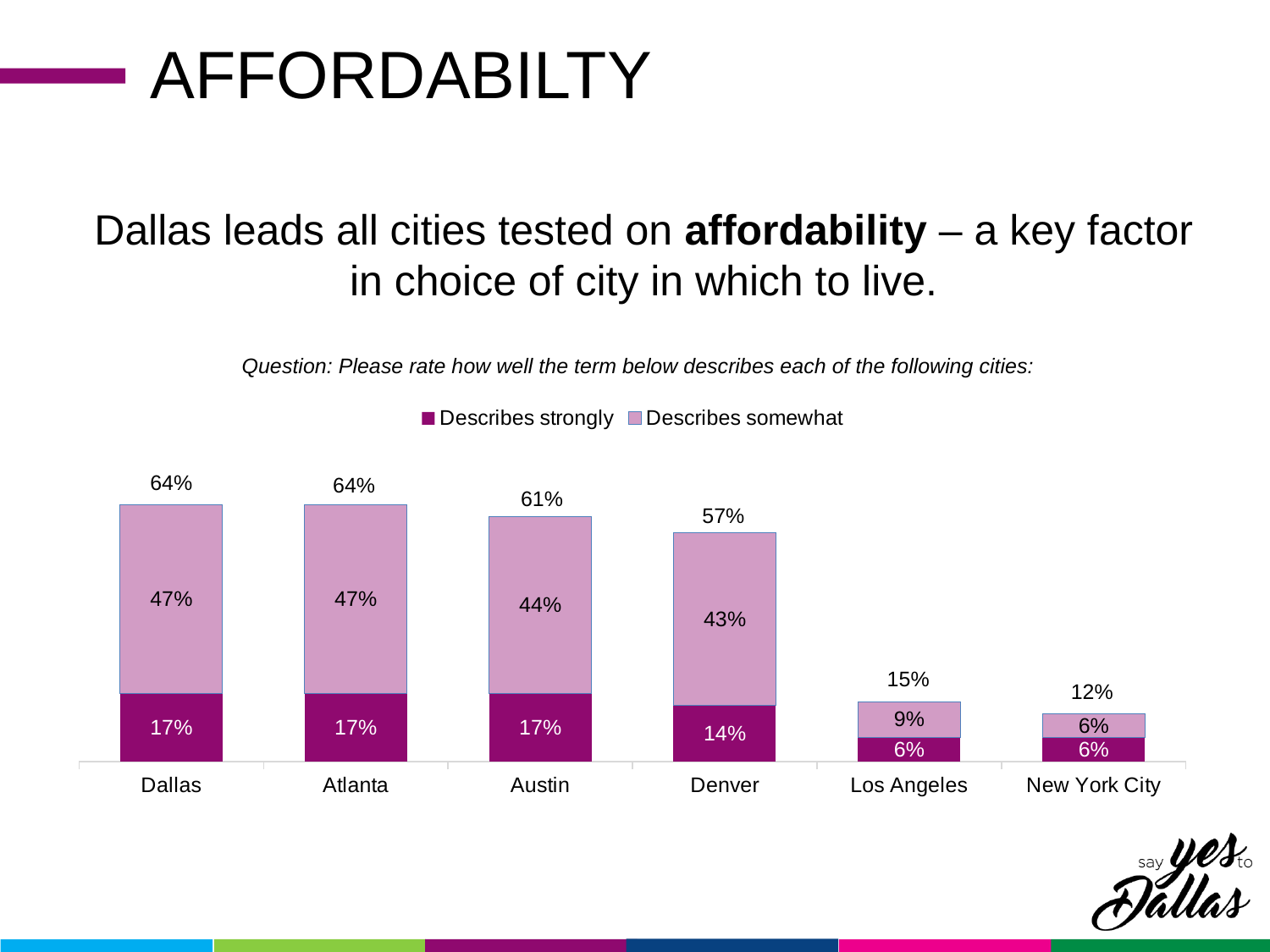
What kind of chart is shown on the slide? Stacked bar chart What is the "Describes somewhat" value for Denver? 43% How many cities are shown on the x axis? 6 What is the total stacked value shown above the bar for Austin? 61% What percentage of respondents said affordability "Describes strongly" for Dallas? 17% How many series does the legend list? 2 Which city has the lowest total stacked value? New York City What is the "Describes somewhat" value for Los Angeles? 9% Do the total values rise or fall moving from Dallas to New York City along the x axis? Fall What is the difference between the total for Dallas and the total for Denver? 7% What is the difference between the "Describes somewhat" values for Atlanta and Austin? 3% Which has a larger total, Denver or Los Angeles? Denver